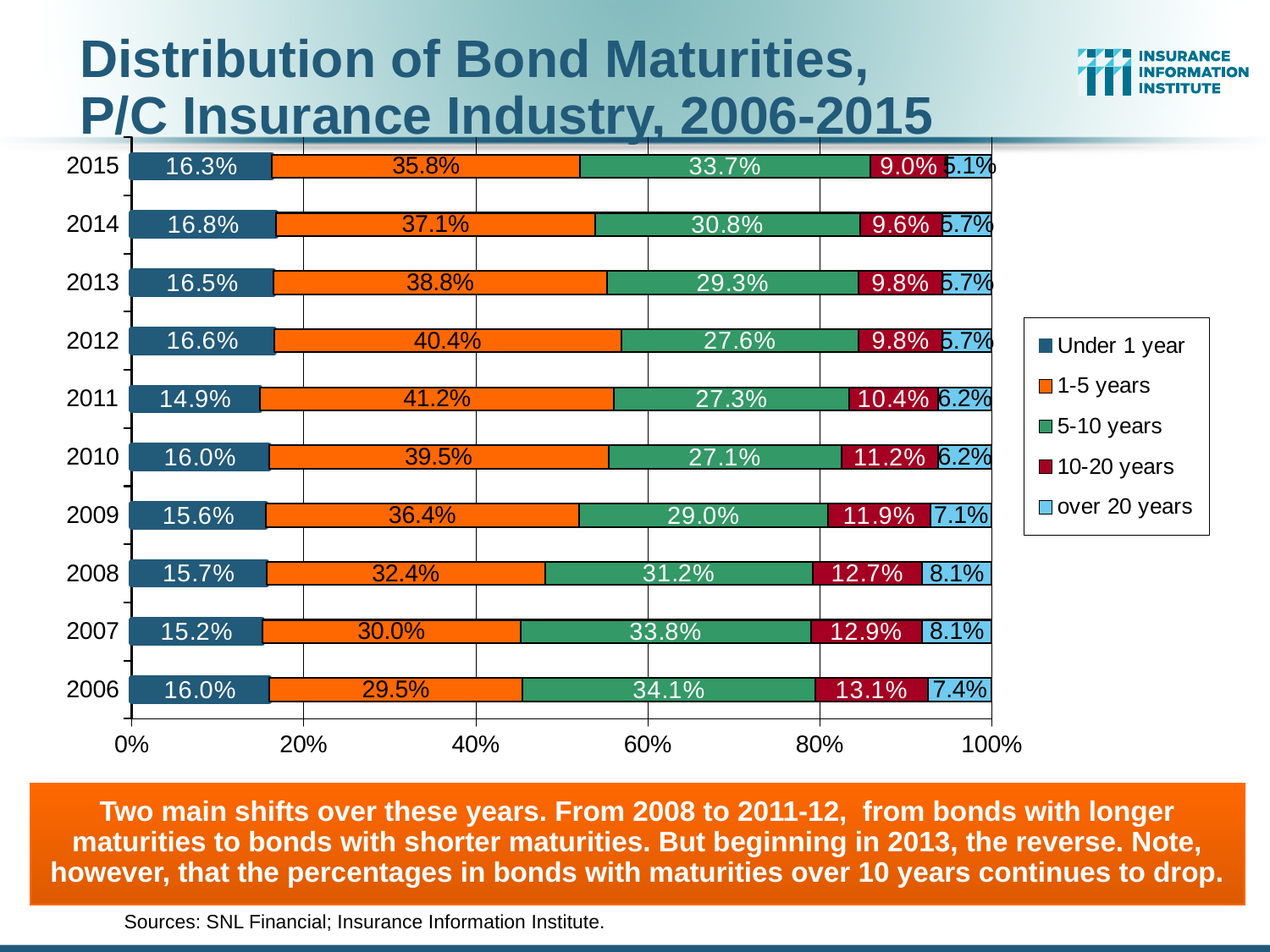
Which is larger, the 5-10 years value in 2015 or in 2014? 2015 What is the difference between the 1-5 years value in 2012 and in 2006? 10.9% What is the value for 10-20 years in 2015? 9.0% What is the value for 5-10 years in 2006? 34.1% How many series does the legend list? 5 Which year has the lowest value for Under 1 year? 2011 Which year has the highest value for 1-5 years? 2011 What is the value for over 20 years in 2008? 8.1% How many years are shown on the chart? 10 What kind of chart is shown on the slide? stacked bar chart Which series is shown in orange in the legend? 1-5 years What is the value for 1-5 years in 2011? 41.2%